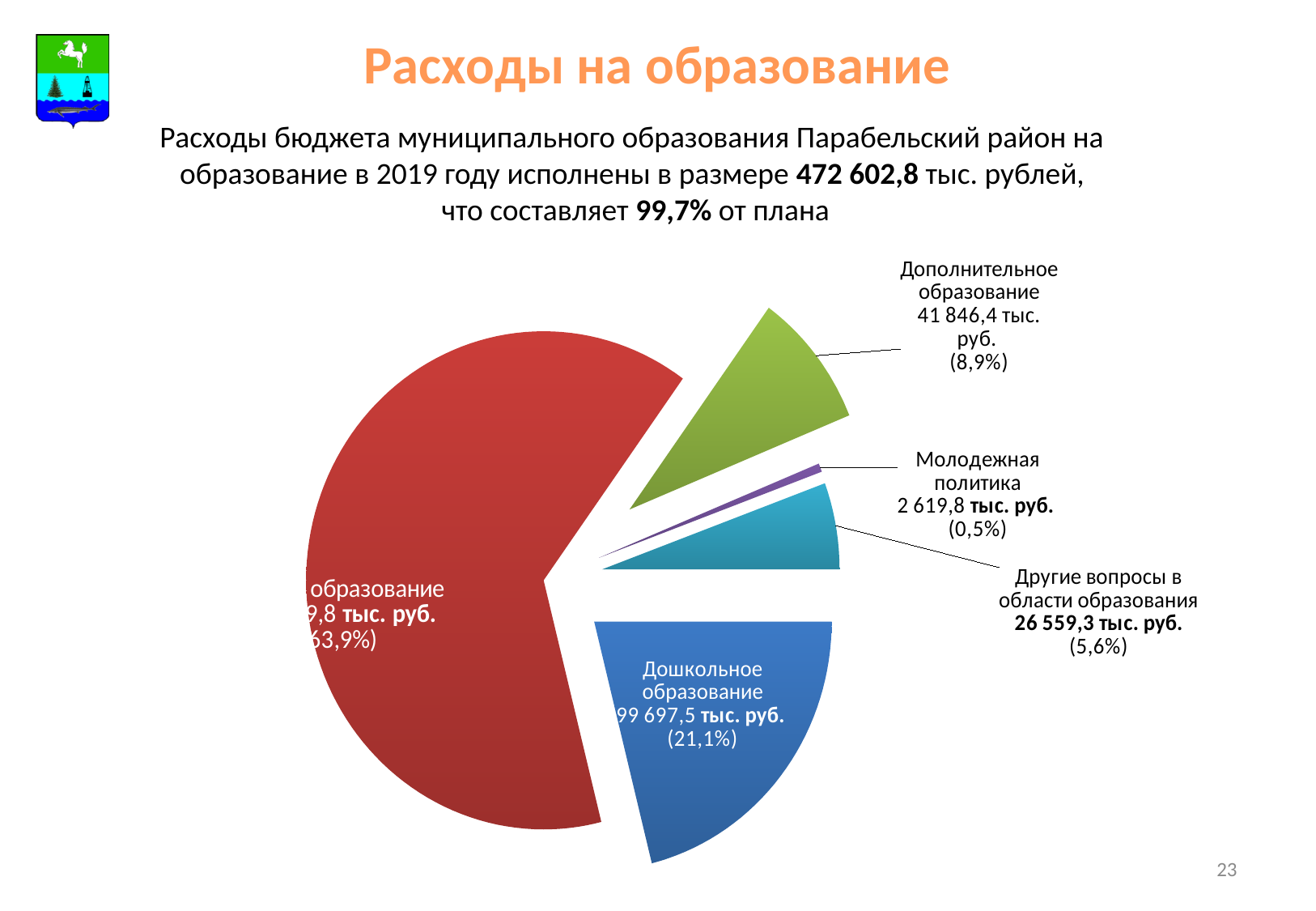
What type of chart is shown on the slide? Pie chart What share of the pie does Дополнительное образование have? 8,9% What is the value shown for Другие вопросы в области образования? 26 559,3 тыс. руб. How many slices does the pie chart have? 5 Which category has the smallest slice of the pie? Молодежная политика What share of the pie does Дошкольное образование have? 21,1% What percentage is shown for the red slice of the pie? 63,9% What is the value shown for Дополнительное образование? 41 846,4 тыс. руб. What is the difference between the values for Дополнительное образование and Другие вопросы в области образования? 15 287,1 тыс. руб. What is the value shown for Молодежная политика? 2 619,8 тыс. руб. What is the title of the slide? Расходы на образование Which is larger: Дополнительное образование or Другие вопросы в области образования? Дополнительное образование